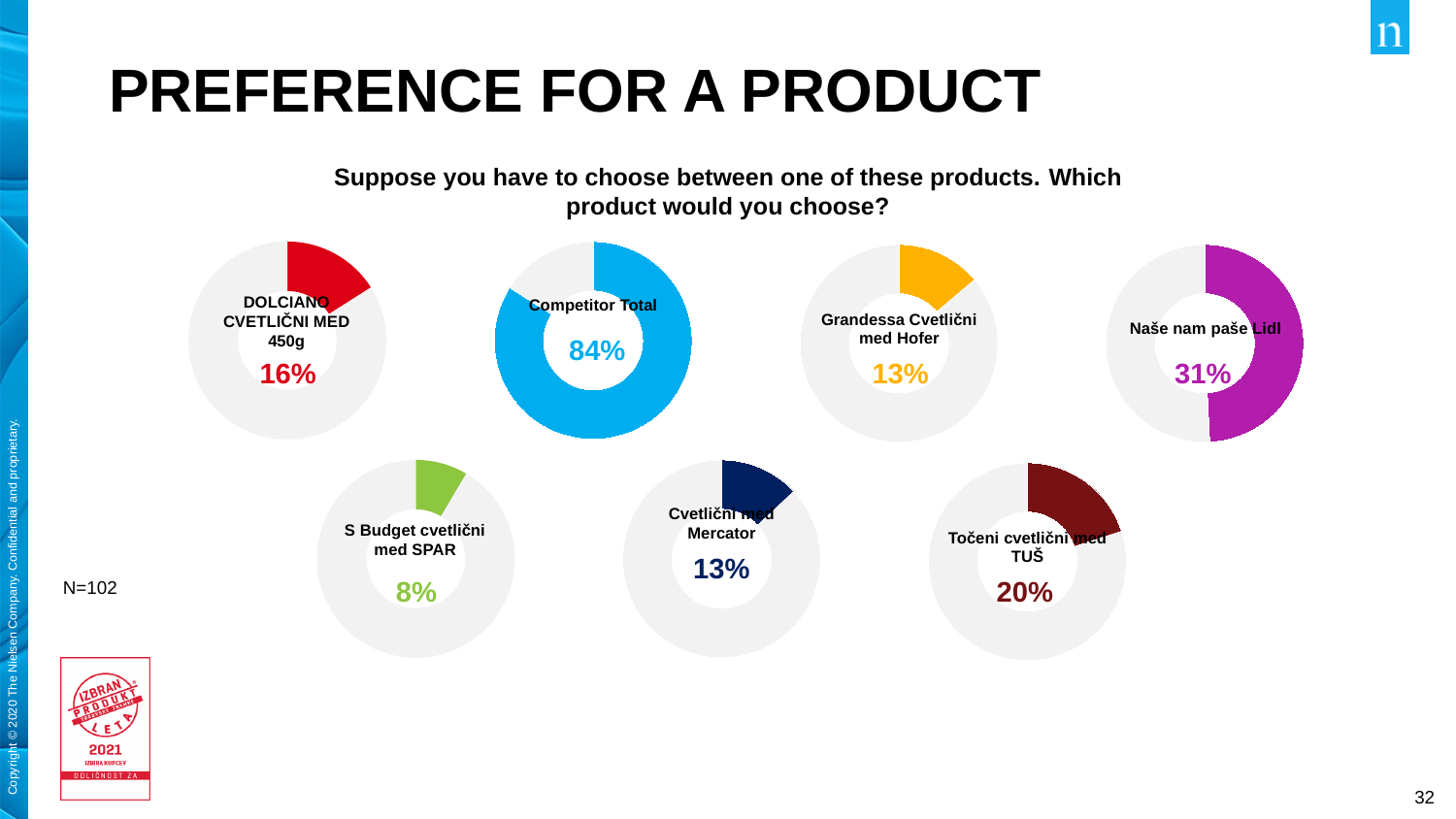
What percentage is shown in the S Budget cvetlični med SPAR donut chart? 8% What percentage is shown in the Competitor Total donut chart? 84% Among the individual competitor products (Hofer, Lidl, SPAR, Mercator, TUŠ), which has the highest percentage? Naše nam paše Lidl Which product has the lowest percentage across all the donut charts on the slide? S Budget cvetlični med SPAR What kind of chart is used to show each product's percentage on the slide? Donut (pie) chart What percentage is shown in the Naše nam paše Lidl donut chart? 31% Which is larger, the percentage for Točeni cvetlični med TUŠ or for Cvetlični med Mercator? Točeni cvetlični med TUŠ What percentage is shown in the DOLCIANO CVETLIČNI MED 450g donut chart? 16% What percentage is shown in the Točeni cvetlični med TUŠ donut chart? 20% What is the difference between the Competitor Total percentage and the DOLCIANO CVETLIČNI MED 450g percentage? 68% What colour is the filled segment of the Competitor Total donut chart? Blue How many donut charts are shown on the slide? 7